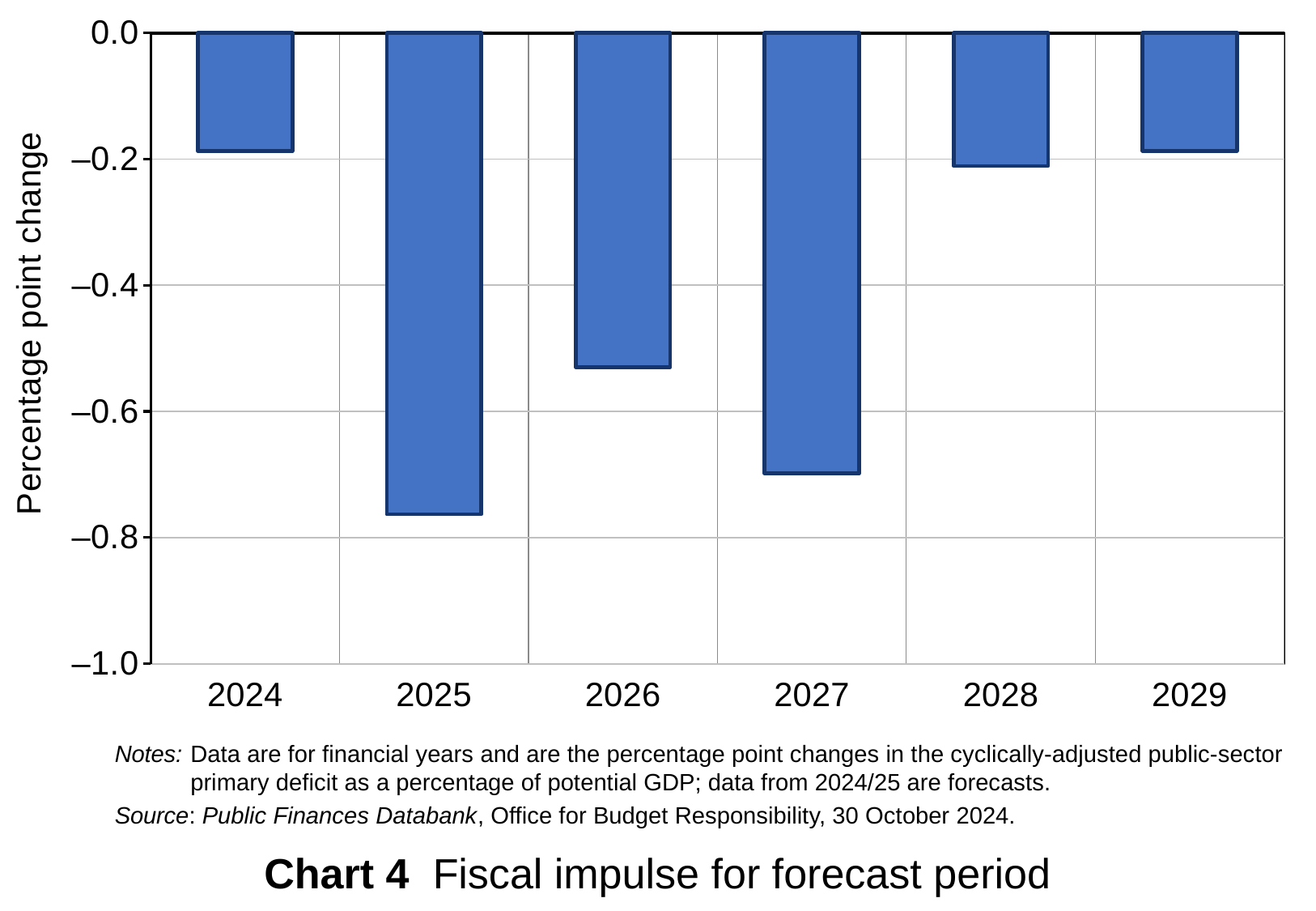
What is the title of the chart? Chart 4 Fiscal impulse for forecast period Which year has the lowest (most negative) value? 2025 Is the value for 2027 greater or less than -0.6? less Is the value for 2025 greater or less than -0.6? less Which year has the larger value, 2027 or 2028? 2028 Is the value for 2026 greater or less than -0.6? greater Which year has the larger value, 2025 or 2026? 2026 What is the label on the vertical axis? Percentage point change What kind of chart is shown on the slide? bar chart How many years are plotted on the x axis? 6